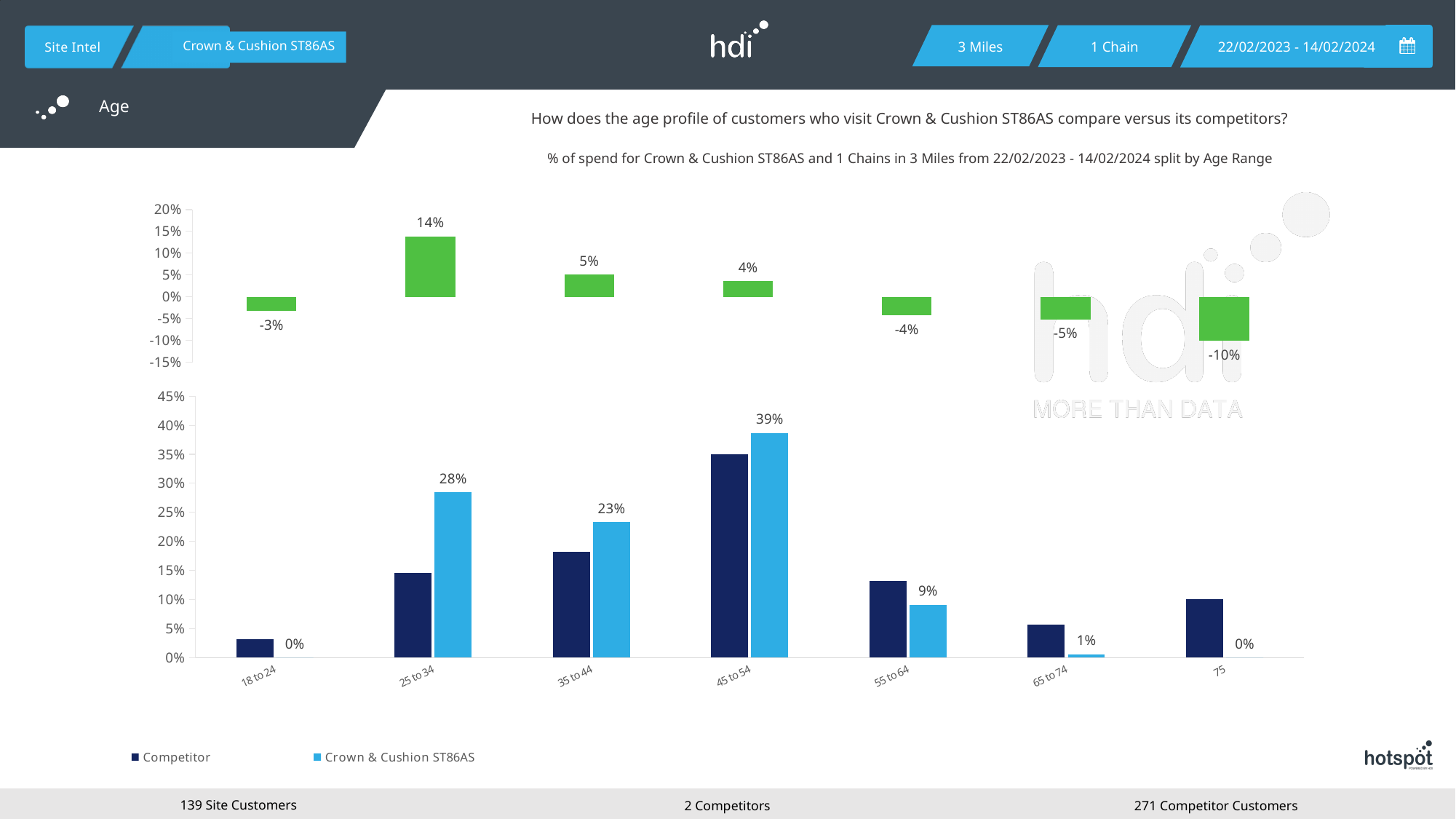
In the top chart, what is the value shown for the 25 to 34 age range? 14% In the bottom chart, what is the value for Crown & Cushion ST86AS in the 25 to 34 age range? 28% In the bottom chart, what is the difference between the Crown & Cushion ST86AS values for 45 to 54 and 35 to 44? 16% How many age range categories are shown on the x axis of the bottom chart? 7 How many series does the legend of the bottom chart list? 2 In the bottom chart, which is larger for the 55 to 64 age range: Competitor or Crown & Cushion ST86AS? Competitor In the bottom chart, which age range has the highest value for Crown & Cushion ST86AS? 45 to 54 What type of chart is the bottom chart? Bar chart In the bottom chart, what is the value for Crown & Cushion ST86AS in the 45 to 54 age range? 39% In the top chart, which age range has the lowest value? 75 In the top chart, what is the value shown for the 75 age range? -10% In the bottom chart, is the Competitor value for 45 to 54 greater or less than 30%? greater